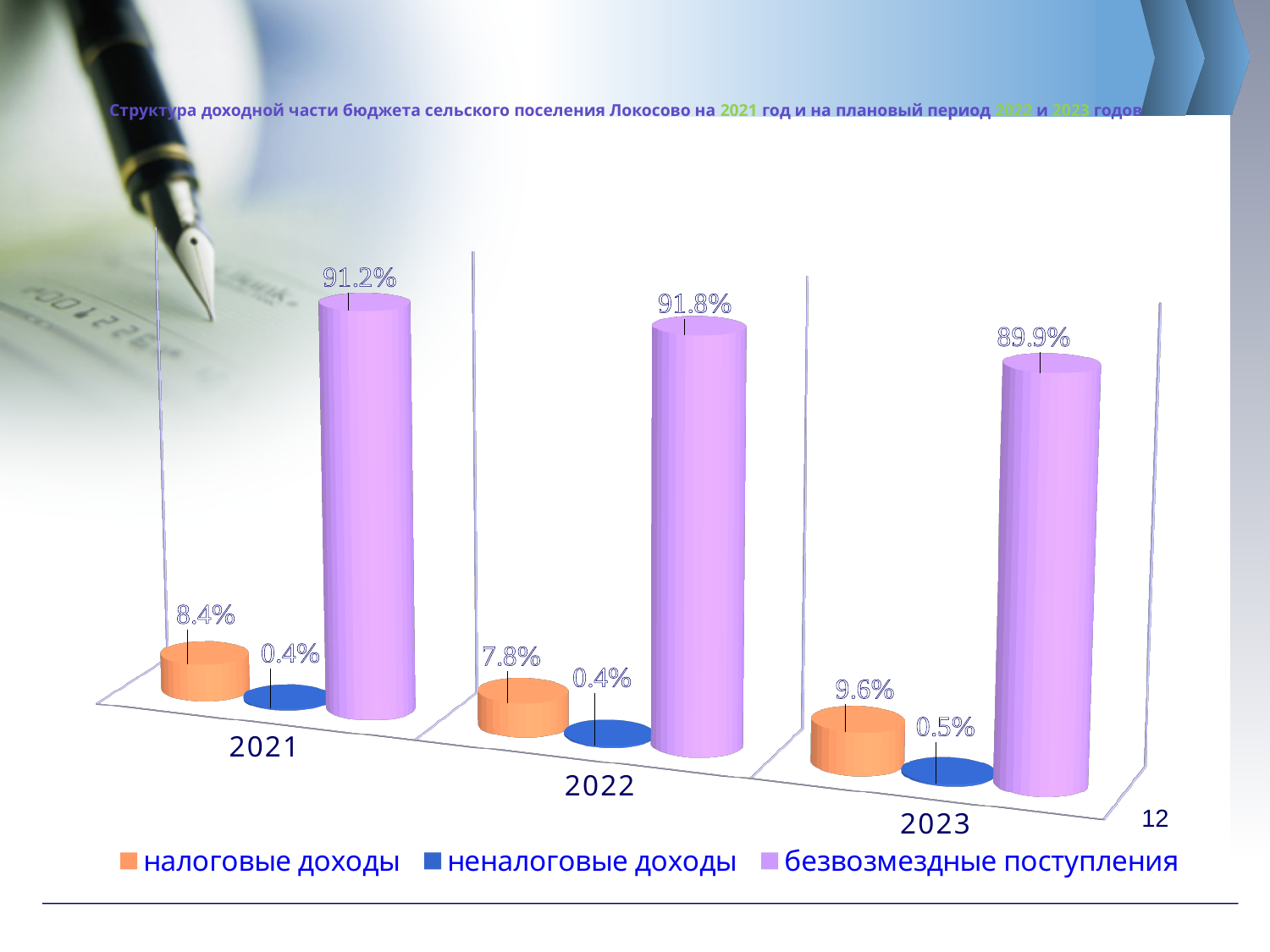
How many series does the legend list? 3 What is the value for безвозмездные поступления in 2022? 91.8% In which year is the value for налоговые доходы the lowest? 2022 What is the difference between the value for безвозмездные поступления in 2021 and in 2023? 1.3% Which is larger: налоговые доходы in 2023 or налоговые доходы in 2021? налоговые доходы in 2023 What is the value for неналоговые доходы in 2023? 0.5% What is the value for безвозмездные поступления in 2023? 89.9% In which year is the value for безвозмездные поступления the highest? 2022 Which series is shown in purple in the legend? безвозмездные поступления How many years are shown on the x axis of the chart? 3 What kind of chart is shown on the slide? bar chart What is the value for налоговые доходы in 2021? 8.4%